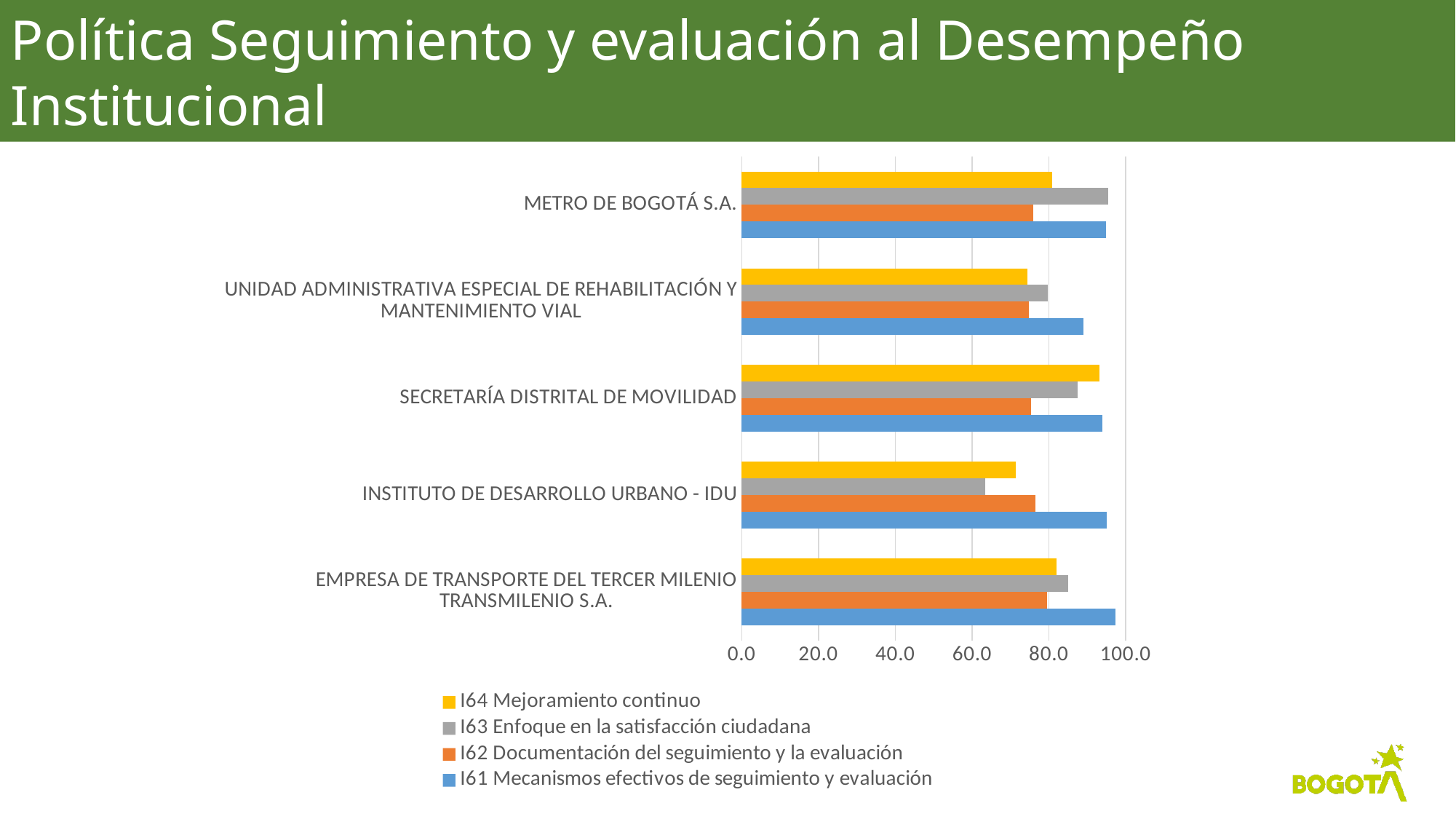
For INSTITUTO DE DESARROLLO URBANO - IDU, which is larger: I63 Enfoque en la satisfacción ciudadana or I61 Mecanismos efectivos de seguimiento y evaluación? I61 Mecanismos efectivos de seguimiento y evaluación Which entity has the highest value for I64 Mejoramiento continuo? SECRETARÍA DISTRITAL DE MOVILIDAD Which colour represents I61 Mecanismos efectivos de seguimiento y evaluación in the legend? blue For METRO DE BOGOTÁ S.A., which is larger: I62 Documentación del seguimiento y la evaluación or I63 Enfoque en la satisfacción ciudadana? I63 Enfoque en la satisfacción ciudadana What kind of chart is shown on the slide? bar chart Is the value of I61 Mecanismos efectivos de seguimiento y evaluación for EMPRESA DE TRANSPORTE DEL TERCER MILENIO TRANSMILENIO S.A. greater or less than 80.0? greater Is the value of I64 Mejoramiento continuo for SECRETARÍA DISTRITAL DE MOVILIDAD greater or less than 80.0? greater Is the value of I64 Mejoramiento continuo for UNIDAD ADMINISTRATIVA ESPECIAL DE REHABILITACIÓN Y MANTENIMIENTO VIAL greater or less than 80.0? less How many entities (categories) are shown on the chart? 5 Which entity has the lowest value for I63 Enfoque en la satisfacción ciudadana? INSTITUTO DE DESARROLLO URBANO - IDU How many series does the legend list? 4